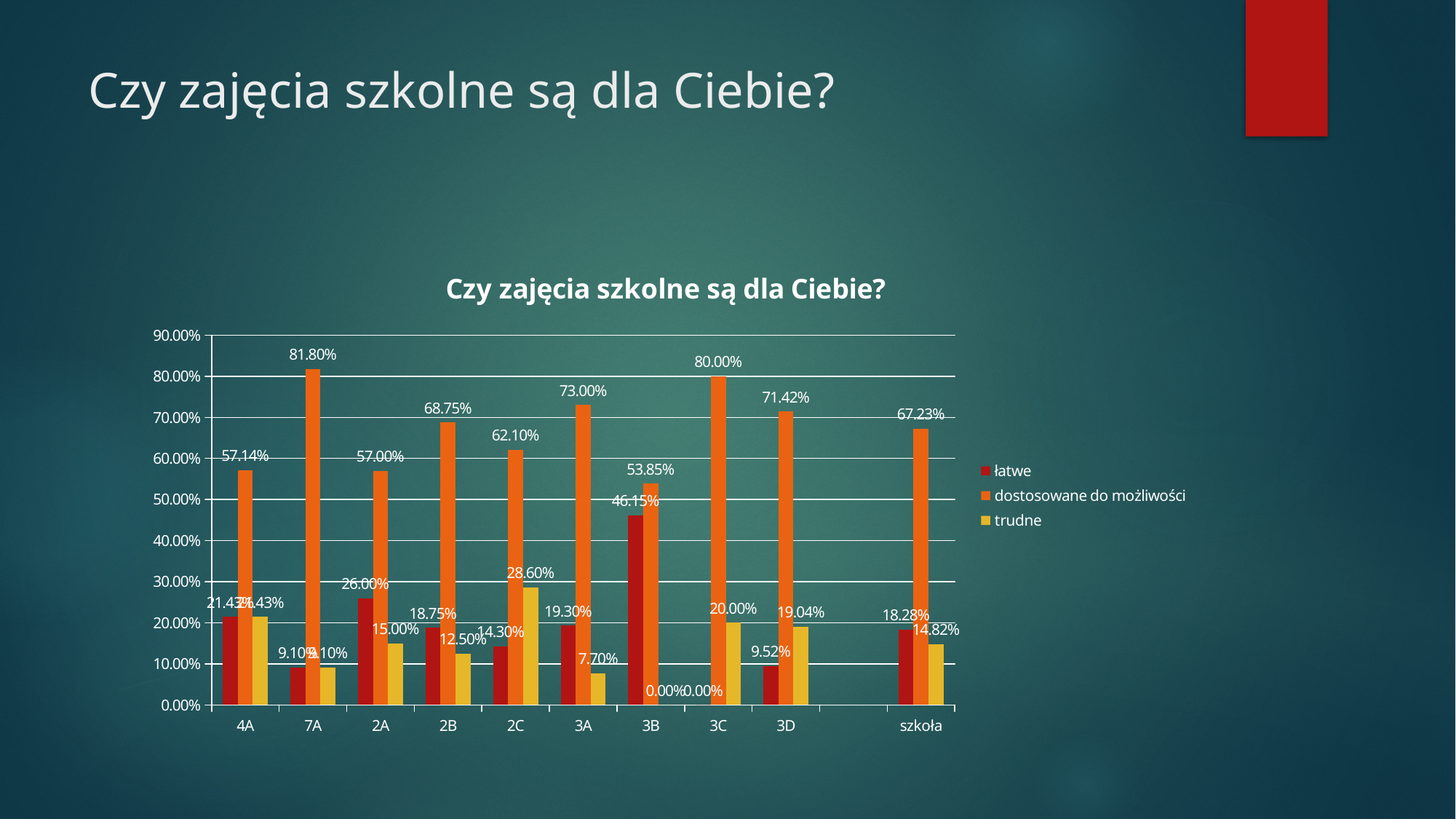
What is the value for 'łatwe' for class 3B? 46.15% What is the difference between the 'dostosowane do możliwości' values for 7A and 4A? 24.66% Which is larger for class 3B: 'łatwe' or 'dostosowane do możliwości'? dostosowane do możliwości How many series does the legend list? 3 What kind of chart is shown on the slide? bar chart What is the value for 'trudne' for class 2C? 28.60% Which category has the highest value for 'trudne'? 2C What is the value for 'dostosowane do możliwości' for class 7A? 81.80% What is the value for 'dostosowane do możliwości' for 'szkoła'? 67.23% Which category has the lowest value for 'dostosowane do możliwości'? 3B Which category has the highest value for 'dostosowane do możliwości'? 7A Is the value for 'dostosowane do możliwości' for class 3C greater or less than 70%? greater